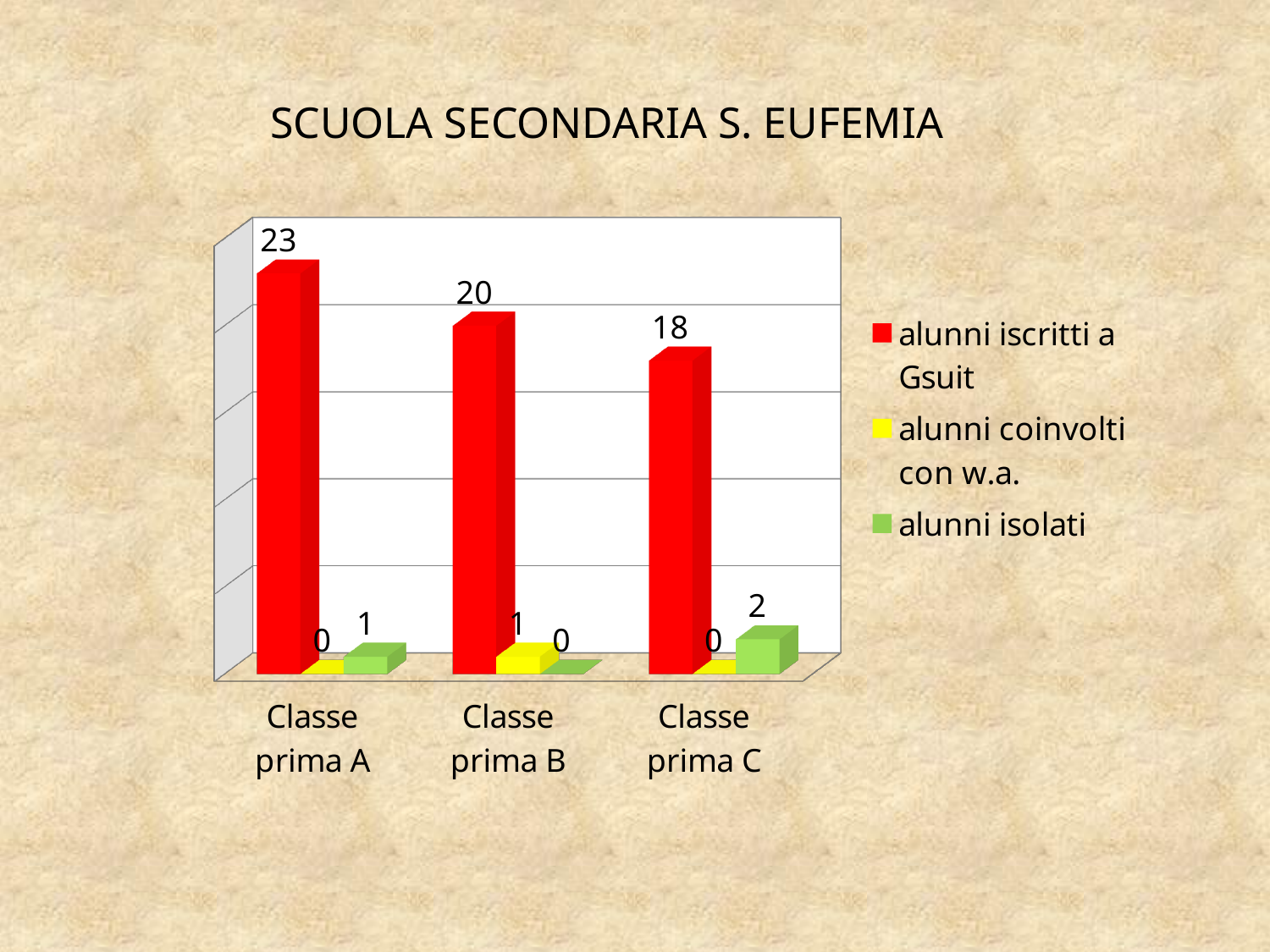
Which class has the highest value for 'alunni iscritti a Gsuit'? Classe prima A What is the difference between 'alunni iscritti a Gsuit' in Classe prima A and Classe prima B? 3 What is the value for 'alunni iscritti a Gsuit' in Classe prima C? 18 Do the values for 'alunni iscritti a Gsuit' rise or fall from Classe prima A to Classe prima C? Fall Which is larger: 'alunni iscritti a Gsuit' in Classe prima B or in Classe prima C? Classe prima B What is the value for 'alunni coinvolti con w.a.' in Classe prima B? 1 What kind of chart is shown on the slide? Bar chart How many classes are shown on the x axis? 3 How many series does the legend list? 3 Which class has the lowest value for 'alunni iscritti a Gsuit'? Classe prima C What is the value for 'alunni iscritti a Gsuit' in Classe prima A? 23 What is the value for 'alunni isolati' in Classe prima C? 2